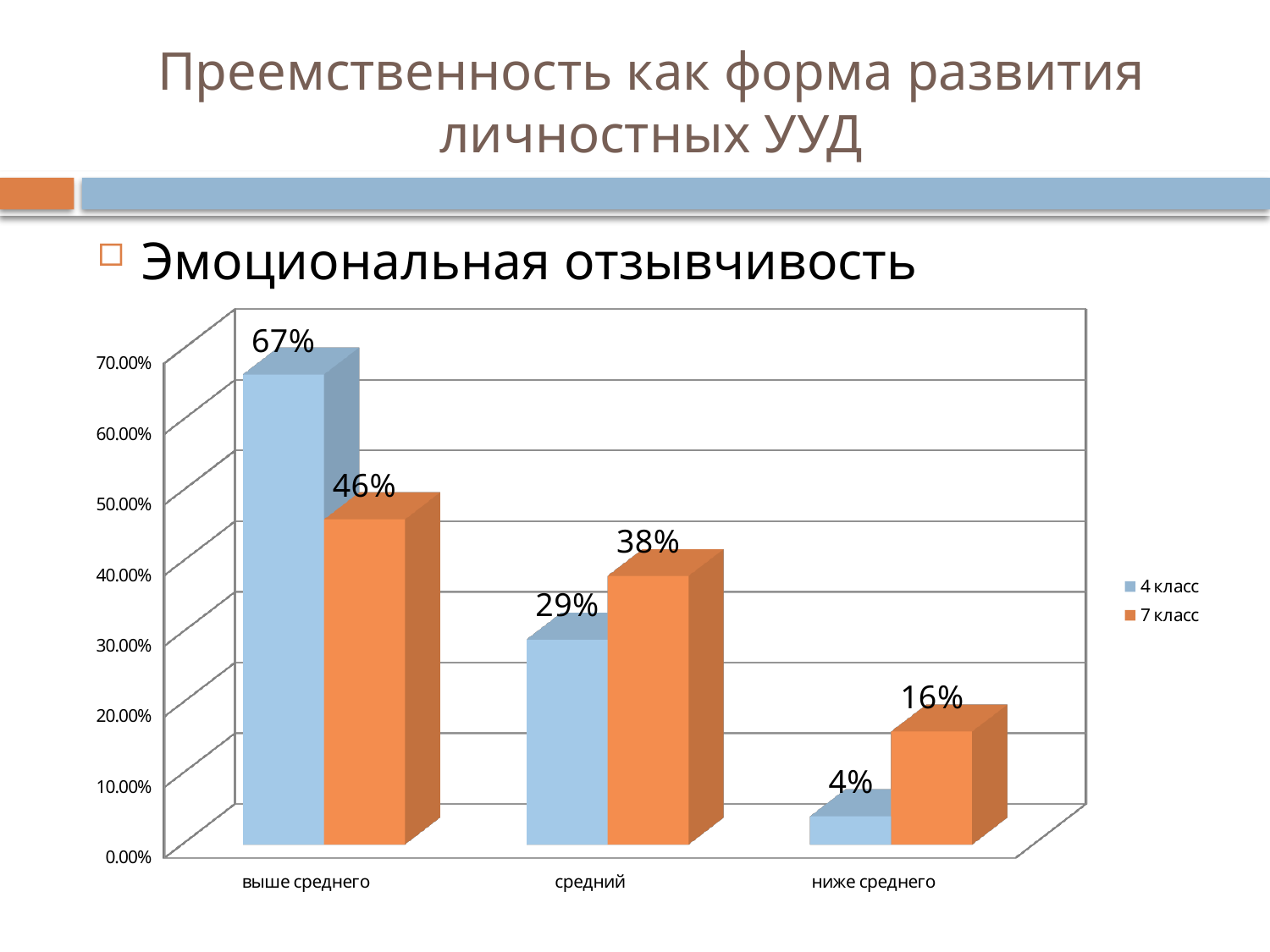
How many series does the legend list? 2 What kind of chart is shown on the slide? bar chart Which category has the lowest value for 7 класс? ниже среднего What is the value for 7 класс in the category ниже среднего? 16% What is the value for 4 класс in the category выше среднего? 67% What is the value for 4 класс in the category ниже среднего? 4% What is the difference between the 4 класс and 7 класс values in the category выше среднего? 21% Which category has the highest value for 4 класс? выше среднего Which colour represents 7 класс in the legend? orange In the category средний, which series has the larger value, 4 класс or 7 класс? 7 класс What is the value for 7 класс in the category средний? 38% How many categories are shown on the x axis? 3